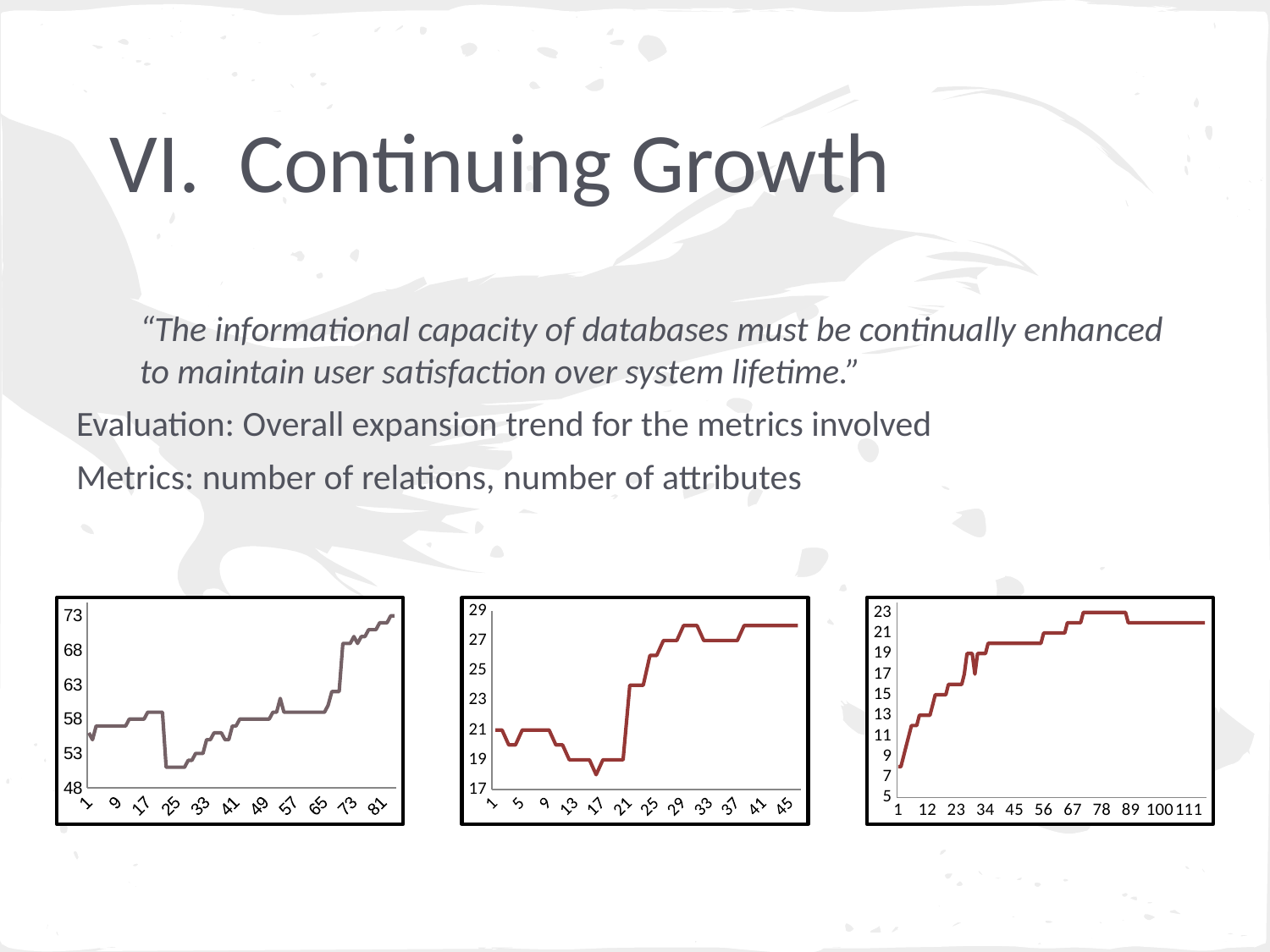
What kind of chart is the left chart on the slide? line chart In the right chart, is the value at x = 1 greater or less than 11? less In the left chart, is the value at x = 25 greater or less than 53? less In the left chart, is the value at x = 81 greater or less than 68? greater In the right chart, do the values overall rise or fall along the x axis? rise What is the highest value shown on the y axis of the middle chart? 29 In the left chart, do the values overall rise or fall from x = 1 to x = 81? rise In the middle chart, what is the value at x = 1? 21 How many charts are shown on the slide? 3